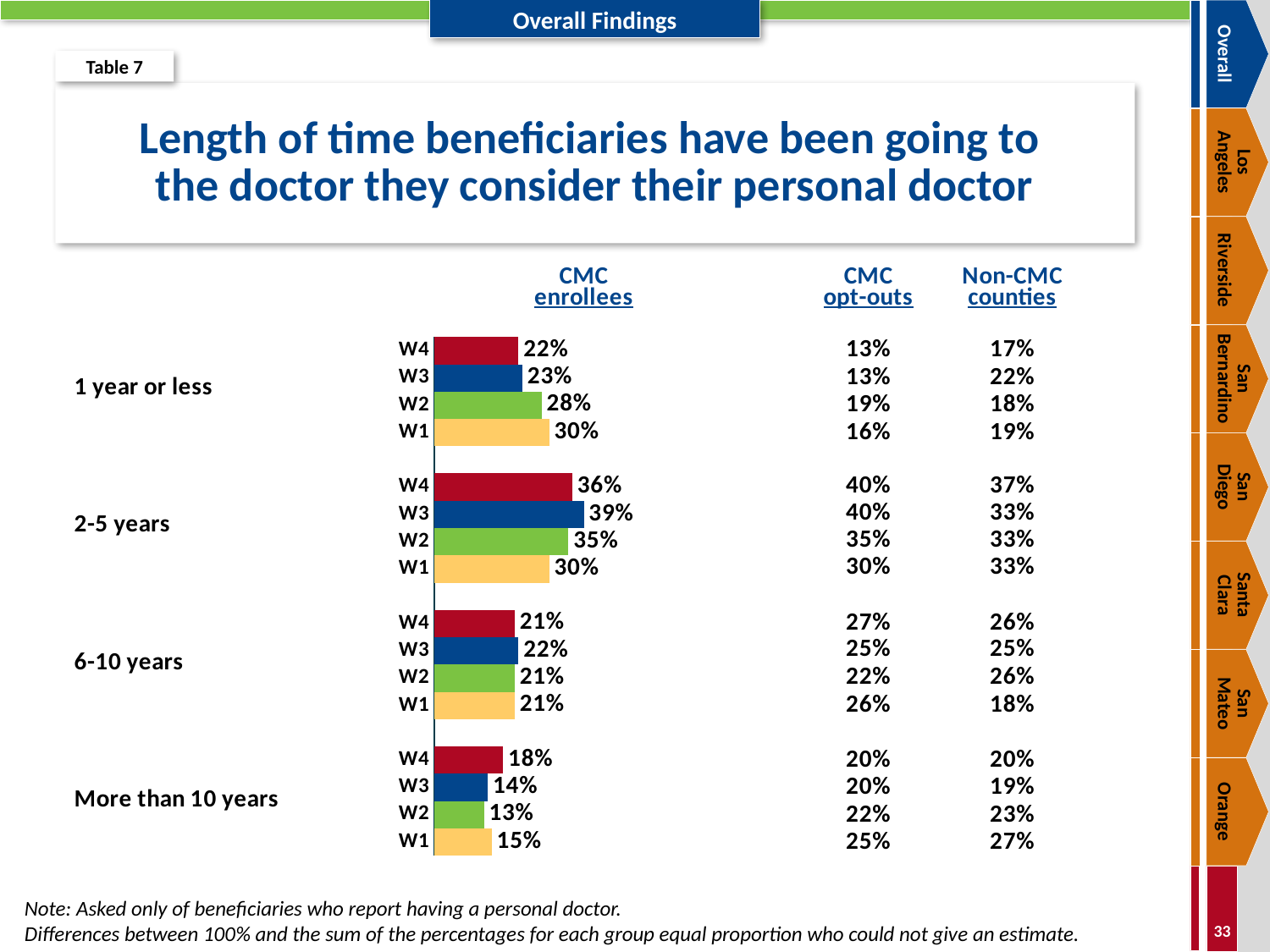
What is the CMC opt-outs value for W4 in the 2-5 years category? 40% What colour are the W4 bars in the CMC enrollees chart? Red For CMC enrollees in the 1 year or less category, do the values rise or fall from W1 to W4? Fall How many length-of-time categories are shown on the slide? 4 For CMC enrollees in W4, which is larger: the 1 year or less value or the 2-5 years value? 2-5 years What percentage of CMC enrollees in W4 have been going to their personal doctor for 1 year or less? 22% How many waves (W1-W4) are shown for each length-of-time category? 4 In the More than 10 years category, which wave has the lowest CMC enrollees bar? W2 In the 2-5 years category, which wave has the highest CMC enrollees bar? W3 What kind of chart is used to show the CMC enrollees values? Bar chart What is the CMC enrollees value for W3 in the 2-5 years category? 39% For CMC enrollees in the 1 year or less category, how much higher is W1 than W4? 8 percentage points